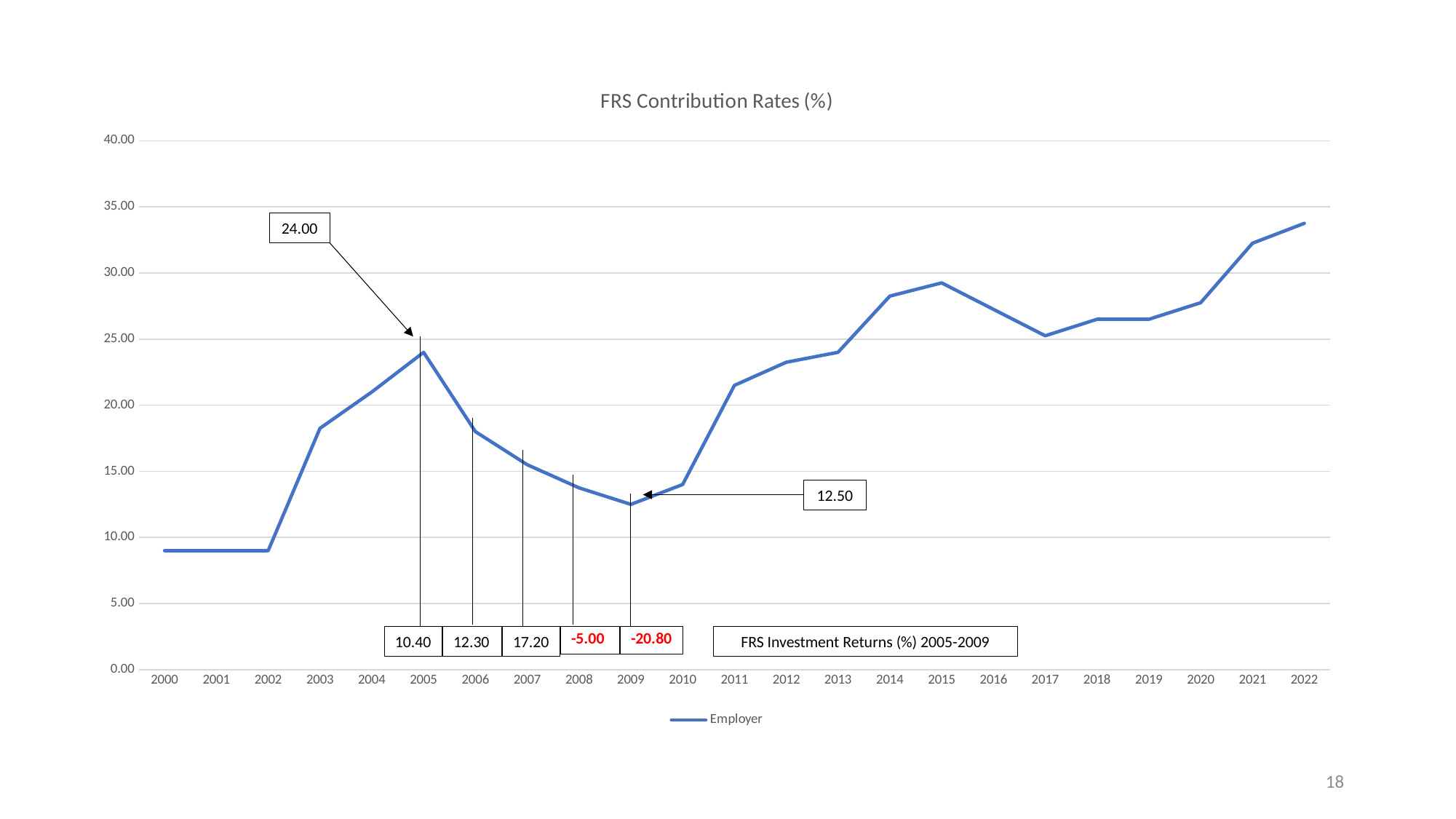
What FRS investment return (%) is shown for 2009? -20.80 Which year has the highest Employer contribution rate? 2022 Does the Employer contribution rate rise or fall from 2005 to 2009? fall How many years are plotted along the x axis? 23 How many series does the legend list? 1 Is the Employer contribution rate for 2000 greater or less than 10.00? less What kind of chart is shown on the slide? line chart Is the Employer contribution rate for 2022 greater or less than 30.00? greater What is the Employer contribution rate for 2009? 12.50 What is the title of the chart? FRS Contribution Rates (%) What is the Employer contribution rate for 2005? 24.00 What is the difference between the Employer contribution rate in 2005 and in 2009? 11.50